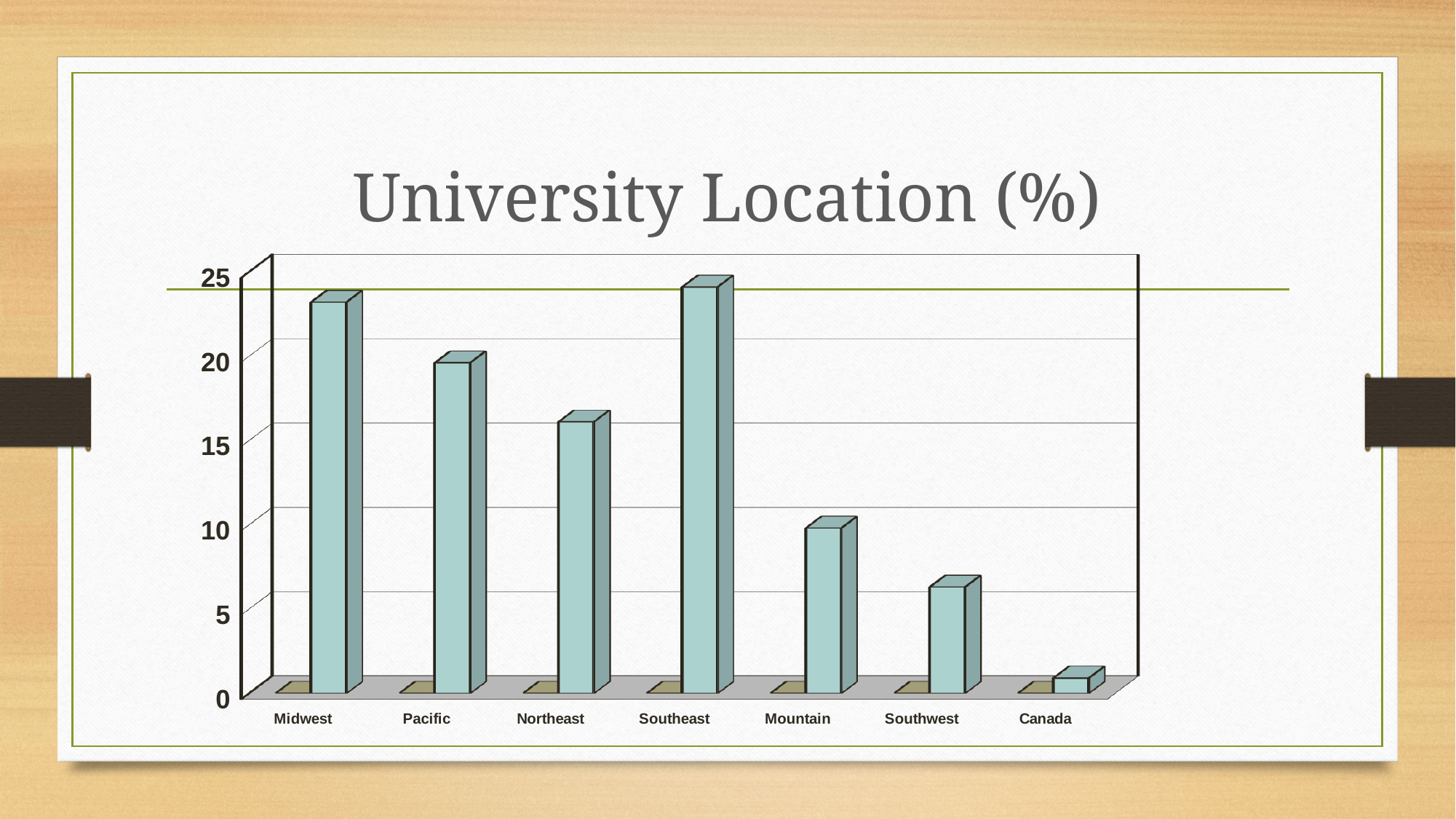
Is the value for Mountain greater or less than 15? less Which category has the highest value in the chart? Southeast Which has a larger value, Mountain or Southwest? Mountain Is the value for Southwest greater or less than 5? greater Is the value for Canada greater or less than 5? less How many categories are shown on the x axis of the chart? 7 What type of chart is shown on the slide? bar chart Which has a larger value, Pacific or Northeast? Pacific What is the title of the chart? University Location (%) Which category has the lowest value in the chart? Canada